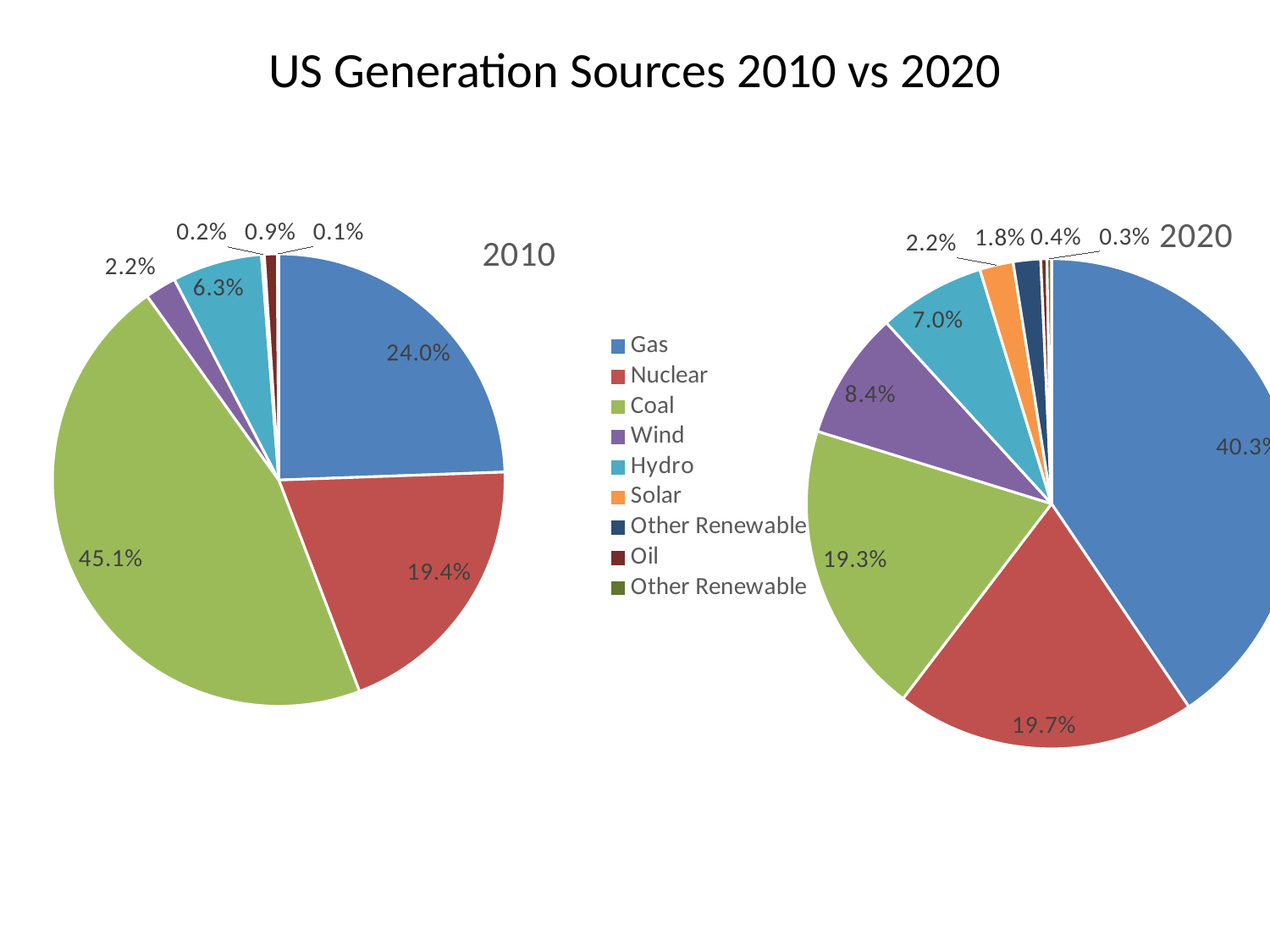
By how many percentage points did the Coal share fall from the 2010 pie chart to the 2020 pie chart? 25.8 percentage points In the 2010 pie chart, what share does Coal have? 45.1% In the 2020 pie chart, which is larger, Nuclear or Coal? Nuclear How many entries does the legend list? 9 What type of charts are shown on the slide? Pie charts In the 2020 pie chart, which source has the largest share? Gas How much larger is the Gas share in the 2020 pie chart than in the 2010 pie chart? 16.3 percentage points In the 2010 pie chart, what share does Hydro have? 6.3% In the 2020 pie chart, what share does Wind have? 8.4% In the 2020 pie chart, what share does Gas have? 40.3% What is the title of the slide? US Generation Sources 2010 vs 2020 In the 2010 pie chart, which source has the largest share? Coal